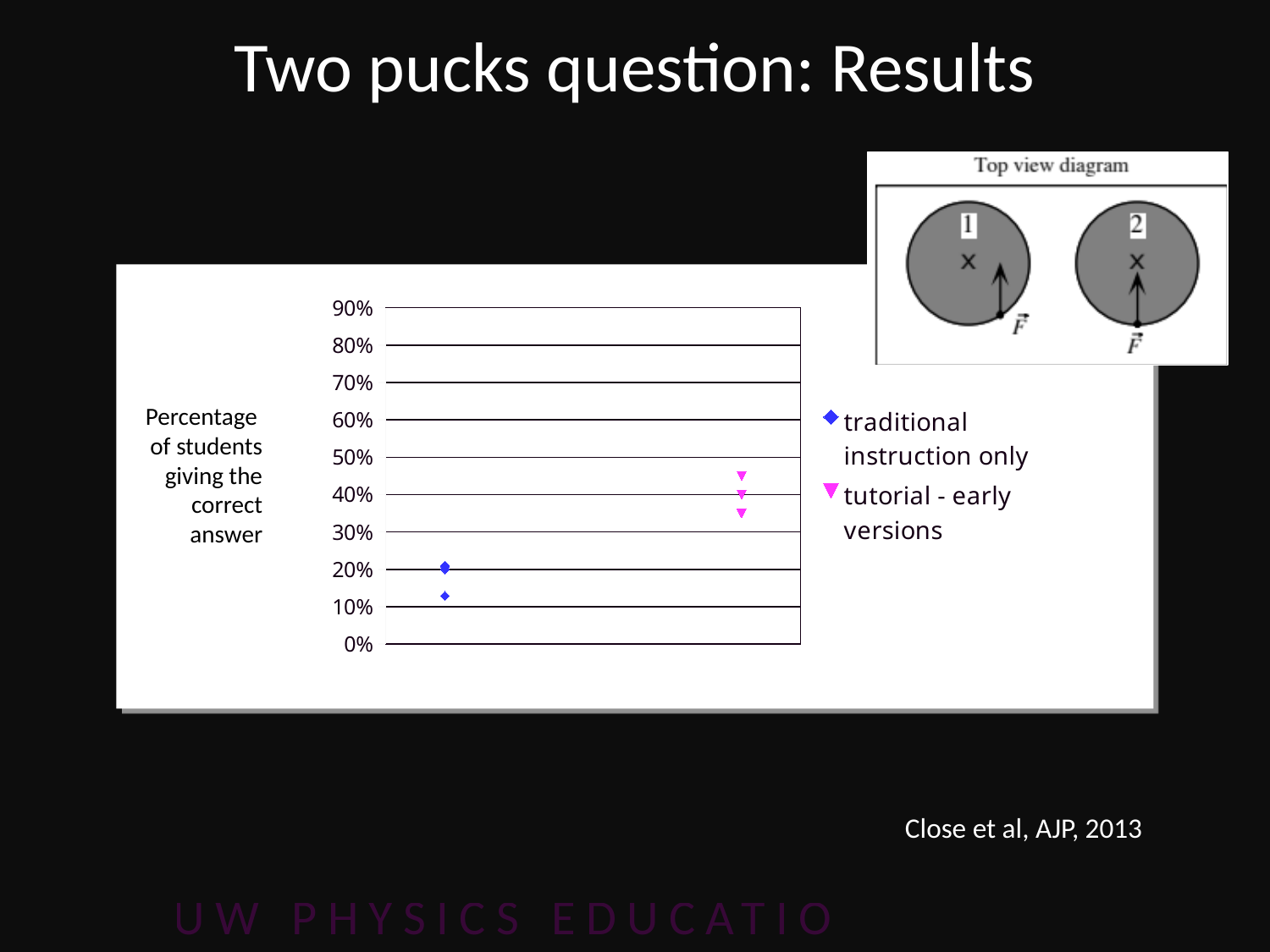
Is the highest value for tutorial - early versions greater or less than 40%? greater How many data points are plotted for the tutorial - early versions series? 3 Are the values for the traditional instruction only series greater or less than 30%? less Is the lowest value for traditional instruction only greater or less than 10%? greater What kind of chart is shown on the slide? scatter chart Which series has the higher values, traditional instruction only or tutorial - early versions? tutorial - early versions What are the two series named in the legend? traditional instruction only; tutorial - early versions How many series does the legend list? 2 What does the y axis of the chart represent? Percentage of students giving the correct answer